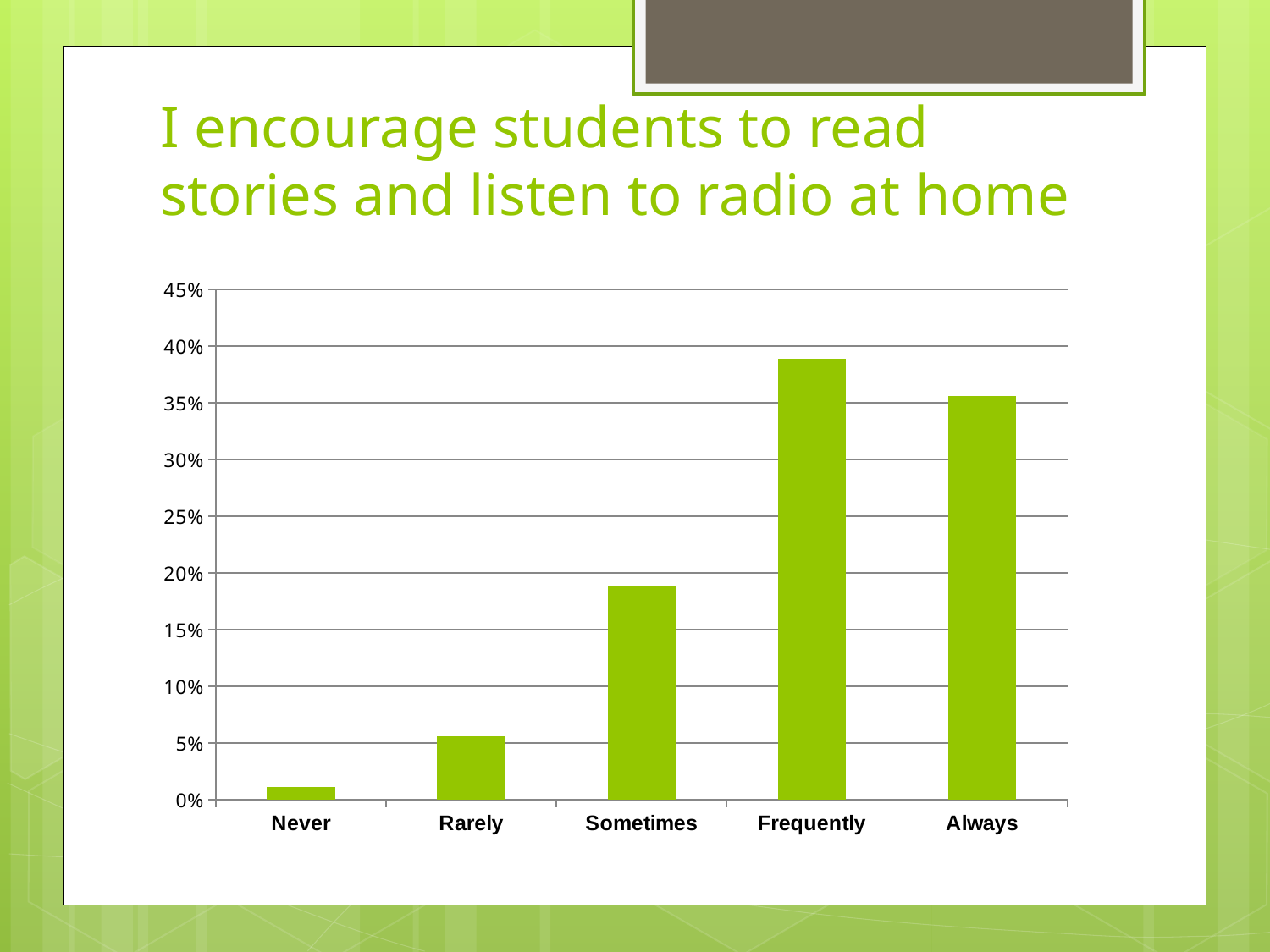
Is the value for Sometimes greater or less than 20%? less Is the value for Never greater or less than 5%? less Is the value for Always greater or less than 30%? greater Which category has the lowest value in the chart? Never What kind of chart is shown on the slide? bar chart Which category has the highest value in the chart? Frequently Which has a larger value, Sometimes or Always? Always Which has a larger value, Rarely or Sometimes? Sometimes What is the title of the slide containing the chart? I encourage students to read stories and listen to radio at home How many categories are shown on the x axis of the chart? 5